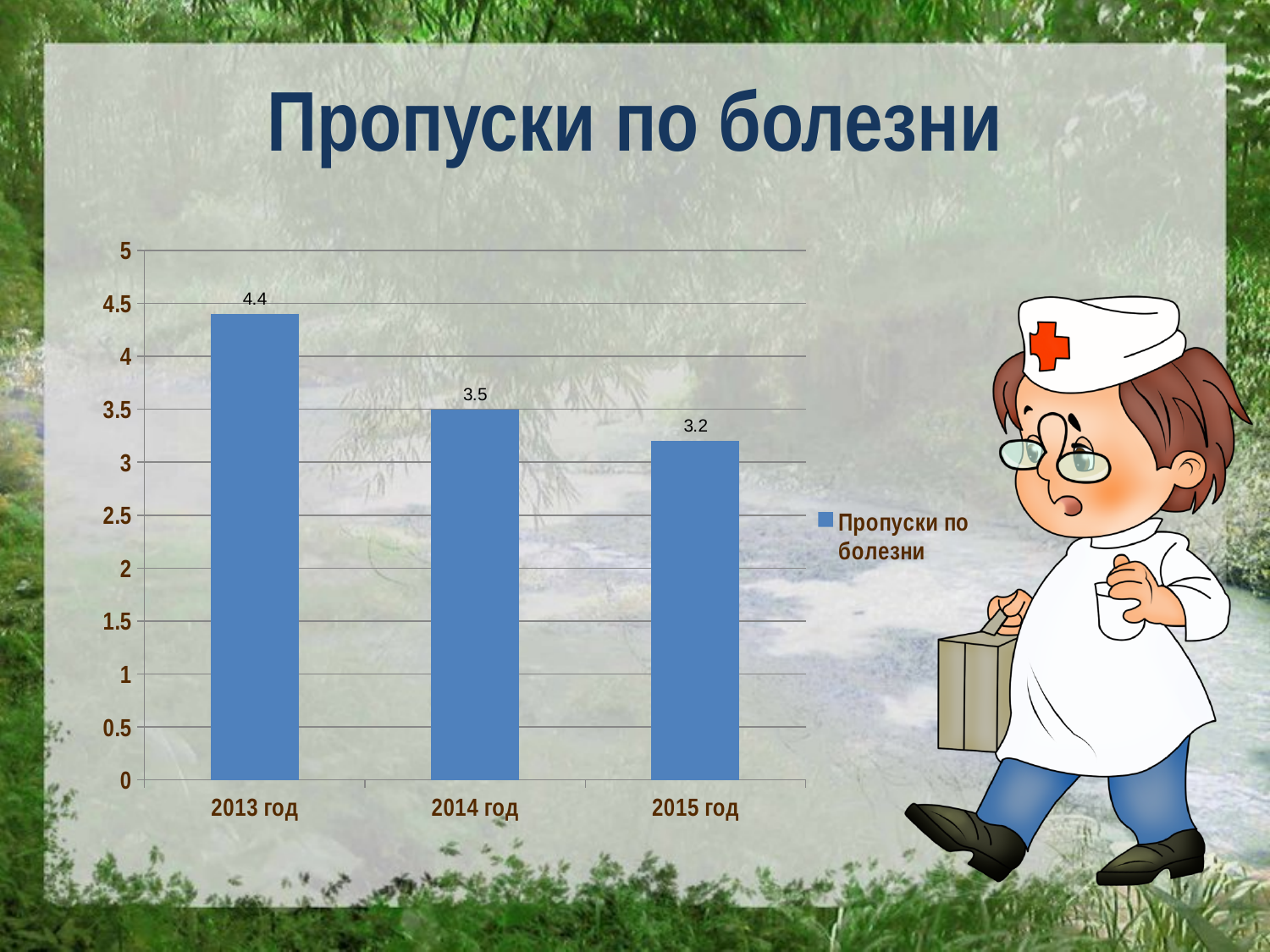
What is the value for 2015 год? 3.2 Which year has the highest value? 2013 год How many years are shown on the x axis? 3 What kind of chart is shown on the slide? bar chart What is the difference between the values for 2013 год and 2014 год? 0.9 Which year has the lowest value? 2015 год Which is larger, the value for 2014 год or the value for 2015 год? 2014 год How many series does the legend list? 1 What is the value for 2013 год? 4.4 Do the values rise or fall from 2013 год to 2015 год? fall What is the difference between the values for 2013 год and 2015 год? 1.2 What is the value for 2014 год? 3.5